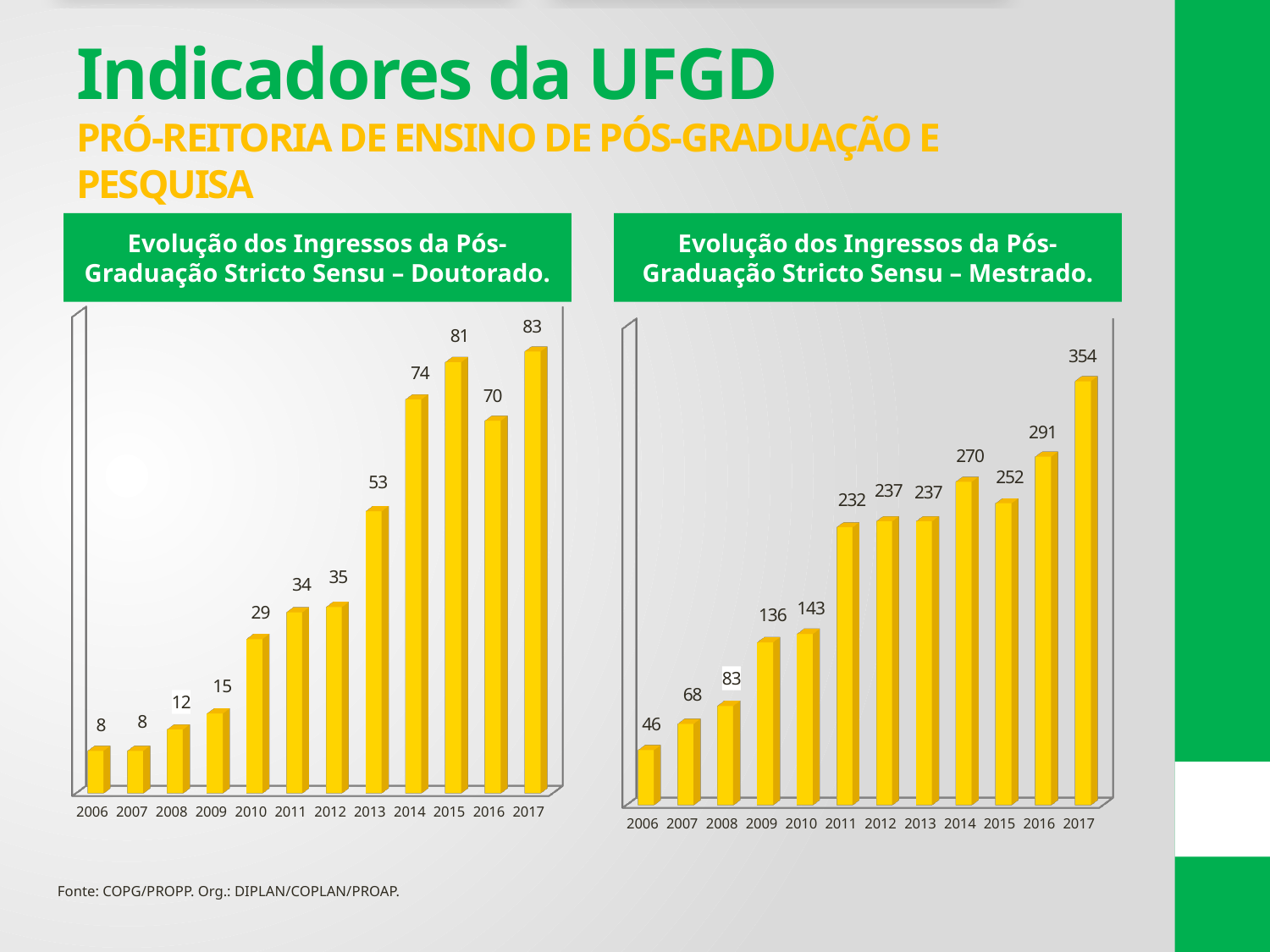
In the Doutorado chart (left), what is the value for 2010? 29 In the Mestrado chart (right), do the values generally rise or fall from 2006 to 2017? rise What is the title of the chart on the right? Evolução dos Ingressos da Pós-Graduação Stricto Sensu – Mestrado. In the Mestrado chart (right), which year has the lowest value? 2006 In the Doutorado chart (left), what is the difference between the values for 2015 and 2016? 11 In the Doutorado chart (left), which year has the highest value? 2017 What kind of chart is the Mestrado chart (right)? bar chart In the Mestrado chart (right), what is the difference between the values for 2017 and 2016? 63 In the Doutorado chart (left), what is the value for 2013? 53 In the Mestrado chart (right), which is larger, the value for 2014 or the value for 2015? 2014 In the Doutorado chart (left), how many years are shown on the x axis? 12 In the Mestrado chart (right), what is the value for 2017? 354